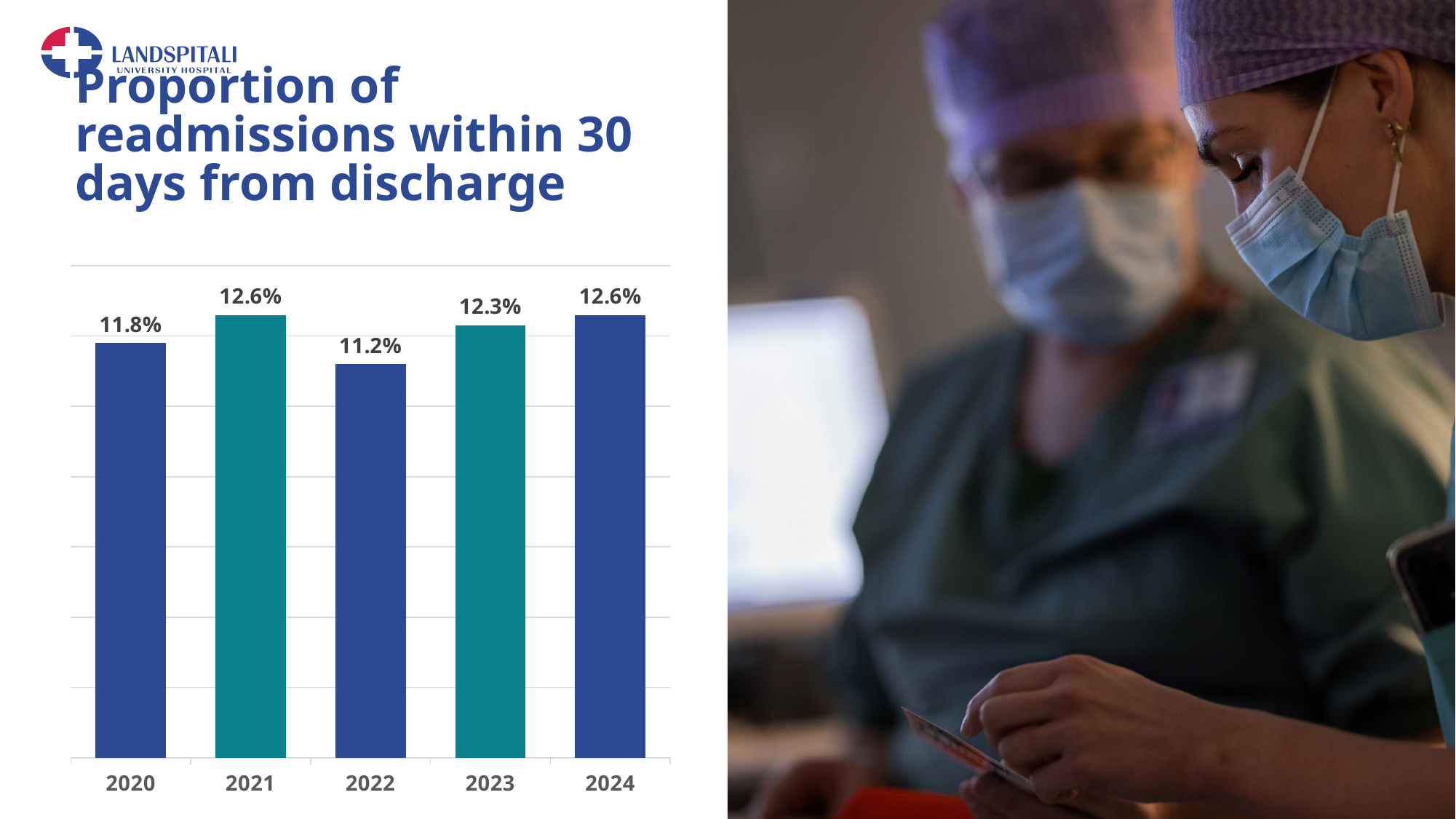
What is the difference in the proportion of readmissions between 2024 and 2020? 0.8% How many years are shown in the chart? 5 What is the proportion of readmissions within 30 days from discharge in 2020? 11.8% What is the title of the chart on the slide? Proportion of readmissions within 30 days from discharge What is the proportion of readmissions within 30 days from discharge in 2022? 11.2% What is the proportion of readmissions within 30 days from discharge in 2024? 12.6% What is the proportion of readmissions within 30 days from discharge in 2023? 12.3% Which year has the lowest proportion of readmissions within 30 days from discharge? 2022 What kind of chart is shown on the slide? Bar chart Which years share the highest proportion of readmissions within 30 days from discharge? 2021 and 2024 Which year has a higher proportion of readmissions, 2020 or 2023? 2023 What is the difference in the proportion of readmissions between 2021 and 2022? 1.4%